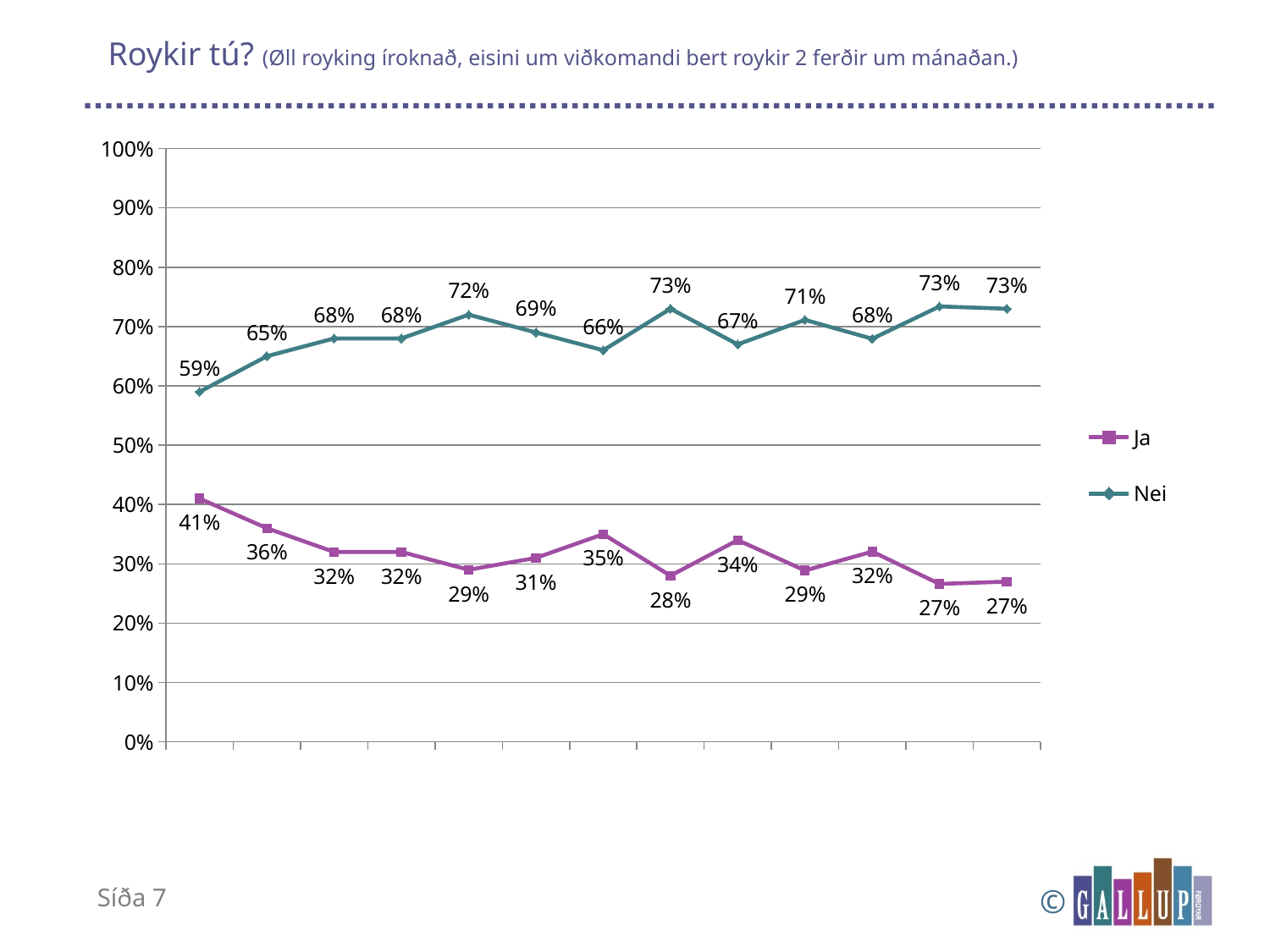
What is the value of the first point of the Nei series? 59% What is the value of the first point of the Ja series? 41% How many series does the legend list? 2 Does the Ja series generally rise or fall from left to right? fall How many data points does the Ja series have? 13 What type of chart is shown on the slide? line chart What is the highest value shown for the Ja series? 41% What are the names of the two series in the legend? Ja and Nei What is the difference between the first and last values of the Ja series? 14% What is the value of the last point of the Nei series? 73% What is the lowest value shown for the Nei series? 59% At the first data point, which series has the larger value, Ja or Nei? Nei